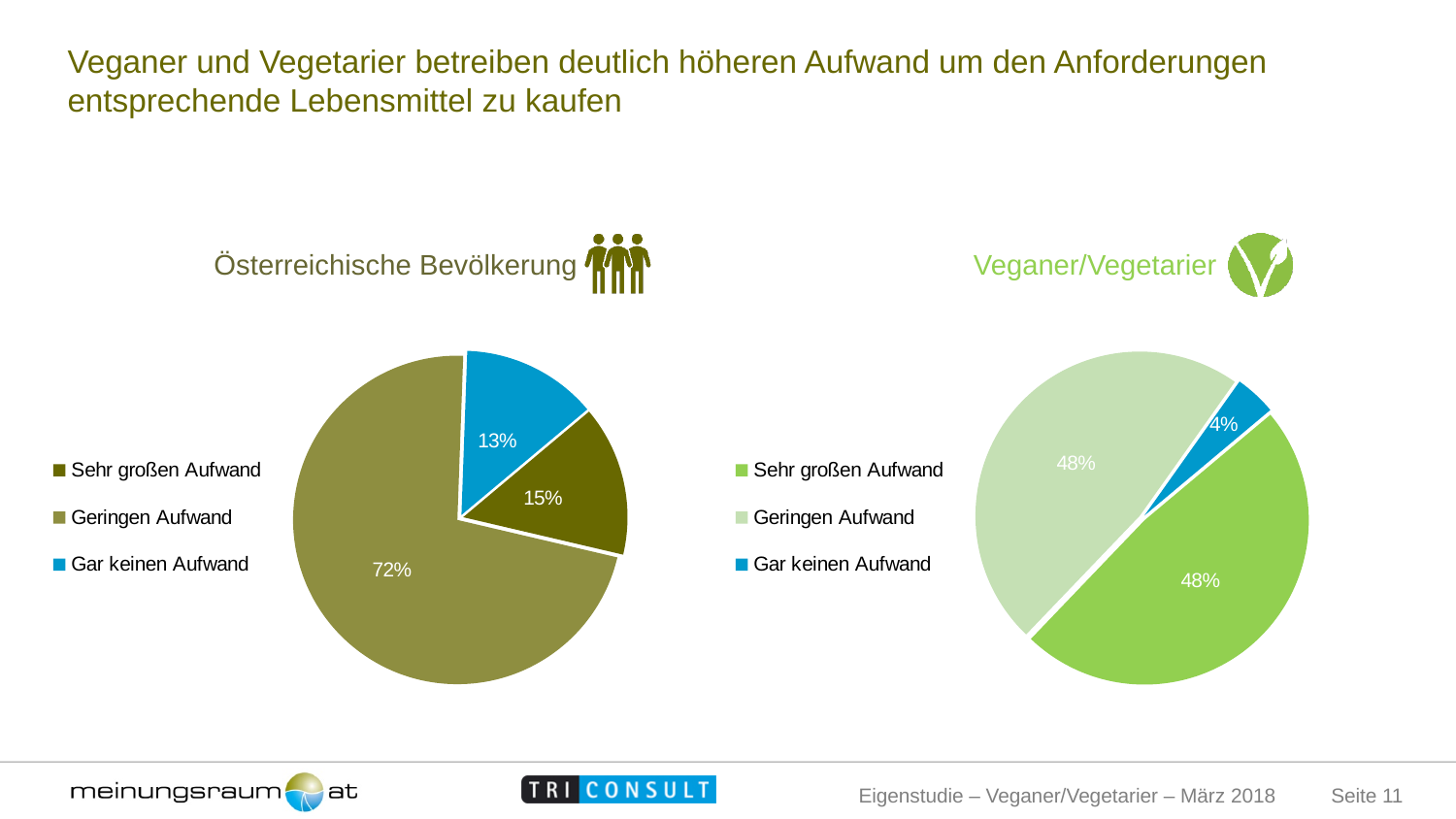
In the 'Veganer/Vegetarier' chart, which category has the smallest slice? Gar keinen Aufwand Which chart shows a larger share for 'Sehr großen Aufwand', 'Österreichische Bevölkerung' or 'Veganer/Vegetarier'? Veganer/Vegetarier In the 'Veganer/Vegetarier' chart, what share is labelled for 'Sehr großen Aufwand'? 48% In the 'Österreichische Bevölkerung' chart, what share is labelled for 'Geringen Aufwand'? 72% In the 'Veganer/Vegetarier' chart, what share is labelled for 'Gar keinen Aufwand'? 4% In the 'Veganer/Vegetarier' chart, what colour is the 'Gar keinen Aufwand' slice? Blue In the 'Österreichische Bevölkerung' chart, what is the difference in percentage points between 'Geringen Aufwand' and 'Sehr großen Aufwand'? 57 How many categories does the legend of the 'Veganer/Vegetarier' chart list? 3 In the 'Österreichische Bevölkerung' chart, what share is labelled for 'Sehr großen Aufwand'? 15% In the 'Österreichische Bevölkerung' chart, which category has the largest slice? Geringen Aufwand In the 'Österreichische Bevölkerung' chart, what share is labelled for 'Gar keinen Aufwand'? 13% What type of chart is used for 'Österreichische Bevölkerung'? Pie chart